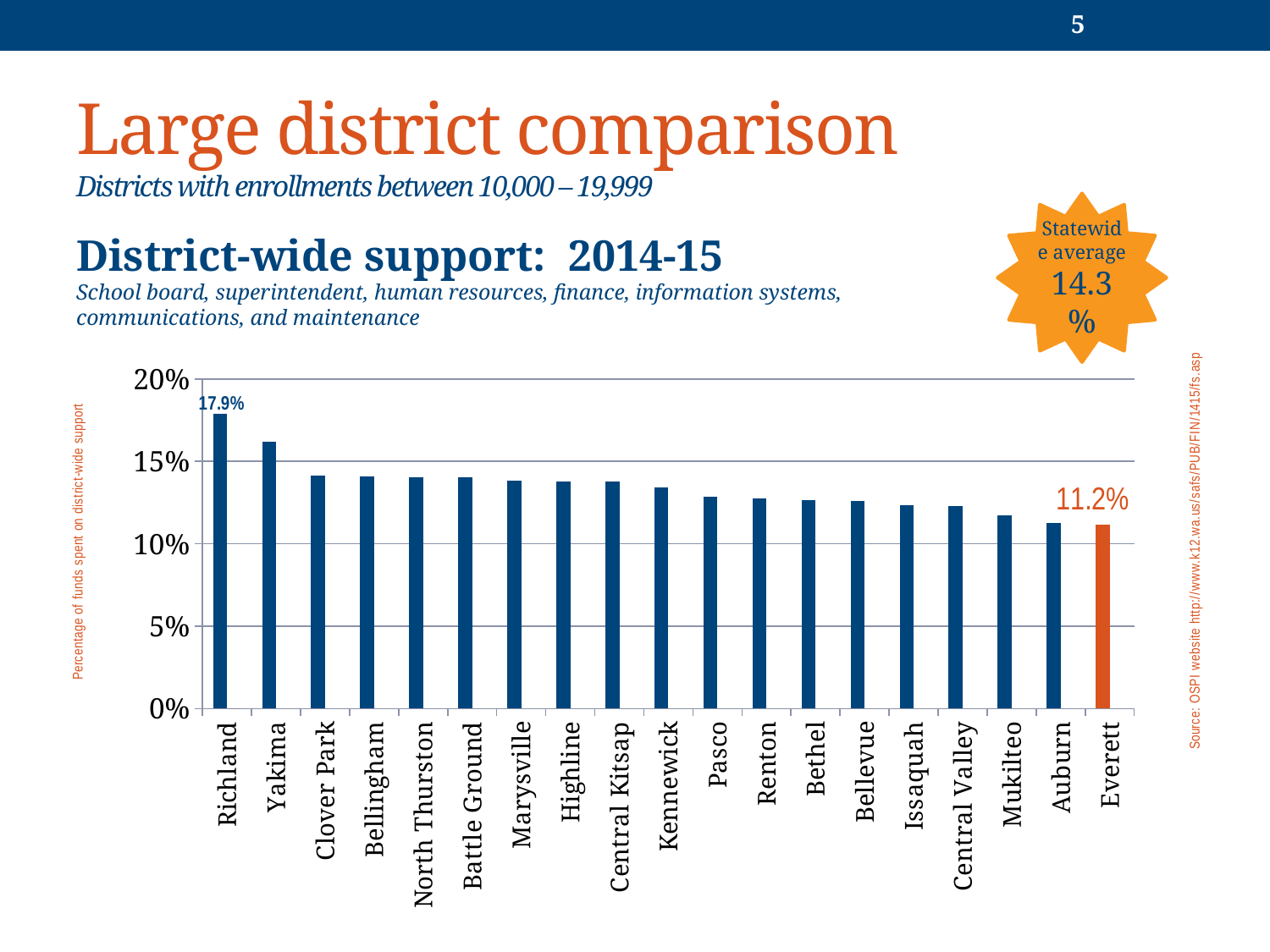
Is the value for Kennewick greater or less than 15%? less What is the value for Everett? 11.2% What is the value for Richland? 17.9% Which district has the highest value? Richland Is the value for Yakima greater or less than 15%? greater How many districts are shown on the chart? 19 Which is larger, the value for Yakima or the value for Clover Park? Yakima Which district's bar is coloured orange instead of blue? Everett What is the difference between the values for Richland and Everett? 6.7% Do the values rise or fall from left to right along the x axis? fall Which district has the lowest value? Everett What type of chart is shown on the slide? bar chart